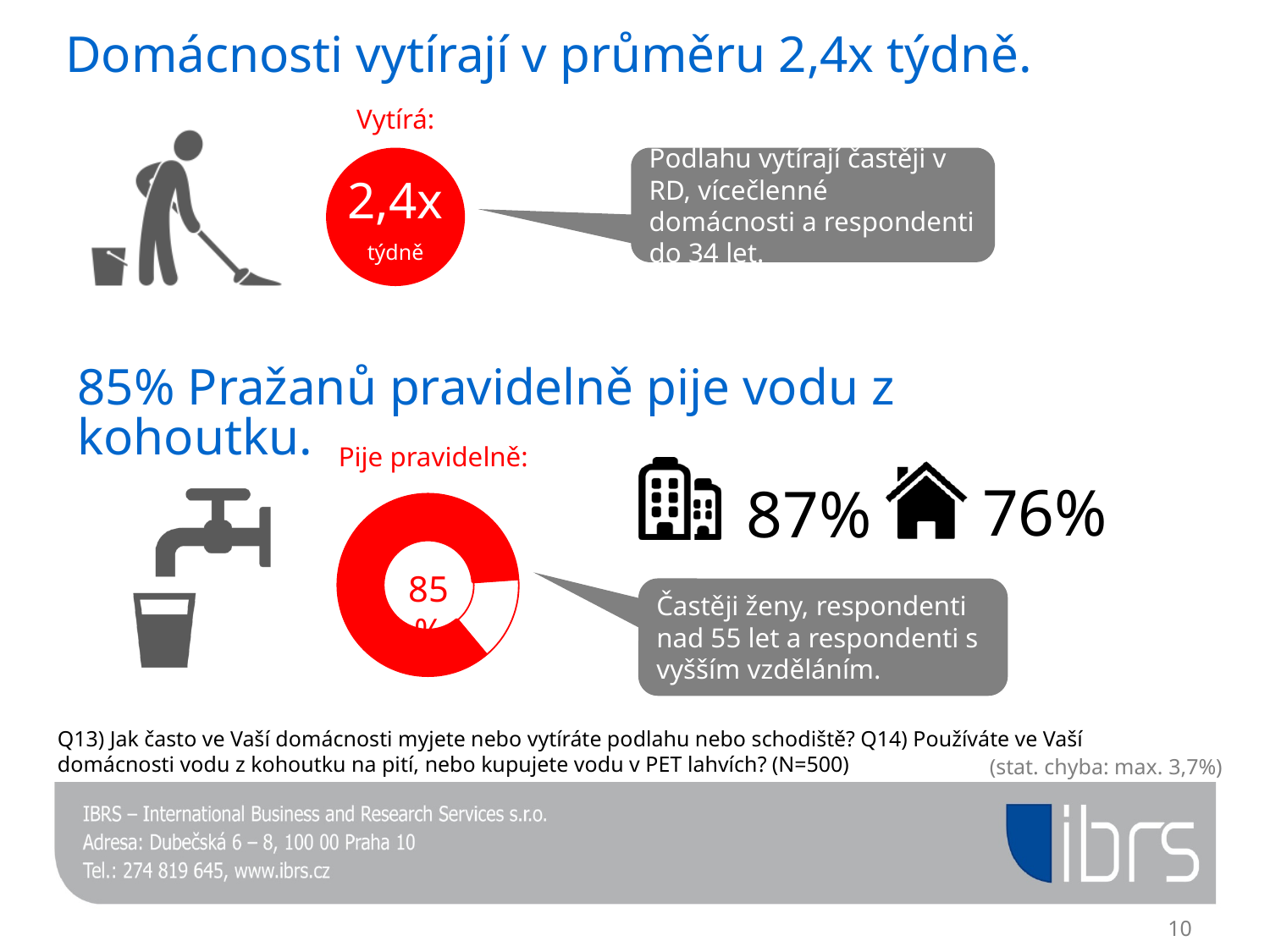
What value is printed in the centre of the doughnut chart labelled "Pije pravidelně:"? 85% What share of the doughnut chart labelled "Pije pravidelně:" does the red slice represent? 85% In the doughnut chart labelled "Pije pravidelně:", is the red slice greater or less than 50% of the whole? greater How many slices does the doughnut chart labelled "Pije pravidelně:" have? 2 In the doughnut chart labelled "Pije pravidelně:", which slice is larger, the red one or the white one? the red one What label appears directly above the doughnut chart on the slide? Pije pravidelně: What colour is the large slice of the doughnut chart labelled "Pije pravidelně:"? red What kind of chart is shown under the label "Pije pravidelně:"? pie chart (doughnut)